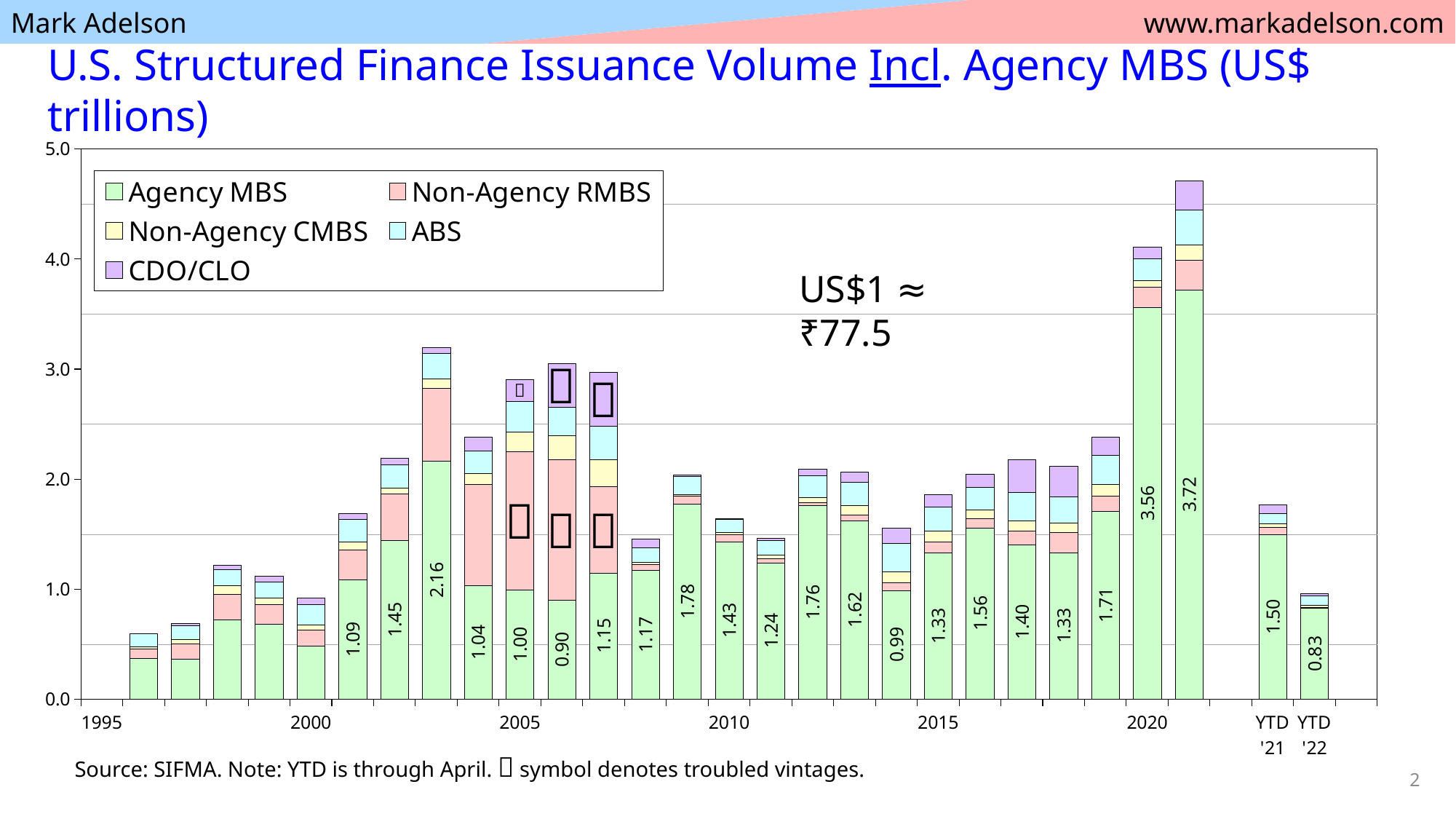
Which is larger, the Agency MBS value for 2009 or for 2012? 2009 What is the difference between the Agency MBS values for 2021 and 2020? 0.16 How many series does the legend list? 5 Among the years with printed Agency MBS labels, which year has the lowest value? 2006 Do the Agency MBS values rise or fall from 2019 to 2021? Rise Is the total stacked bar for 2021 greater or less than 4.0? greater What is the Agency MBS issuance value shown for 2021? 3.72 What kind of chart is shown on the slide? Stacked bar chart Which year has the highest labeled Agency MBS value? 2021 What is the Agency MBS value labeled for YTD '22? 0.83 What is the Agency MBS issuance value shown for 2003? 2.16 Is the total stacked bar for 2008 greater or less than 2.0? less